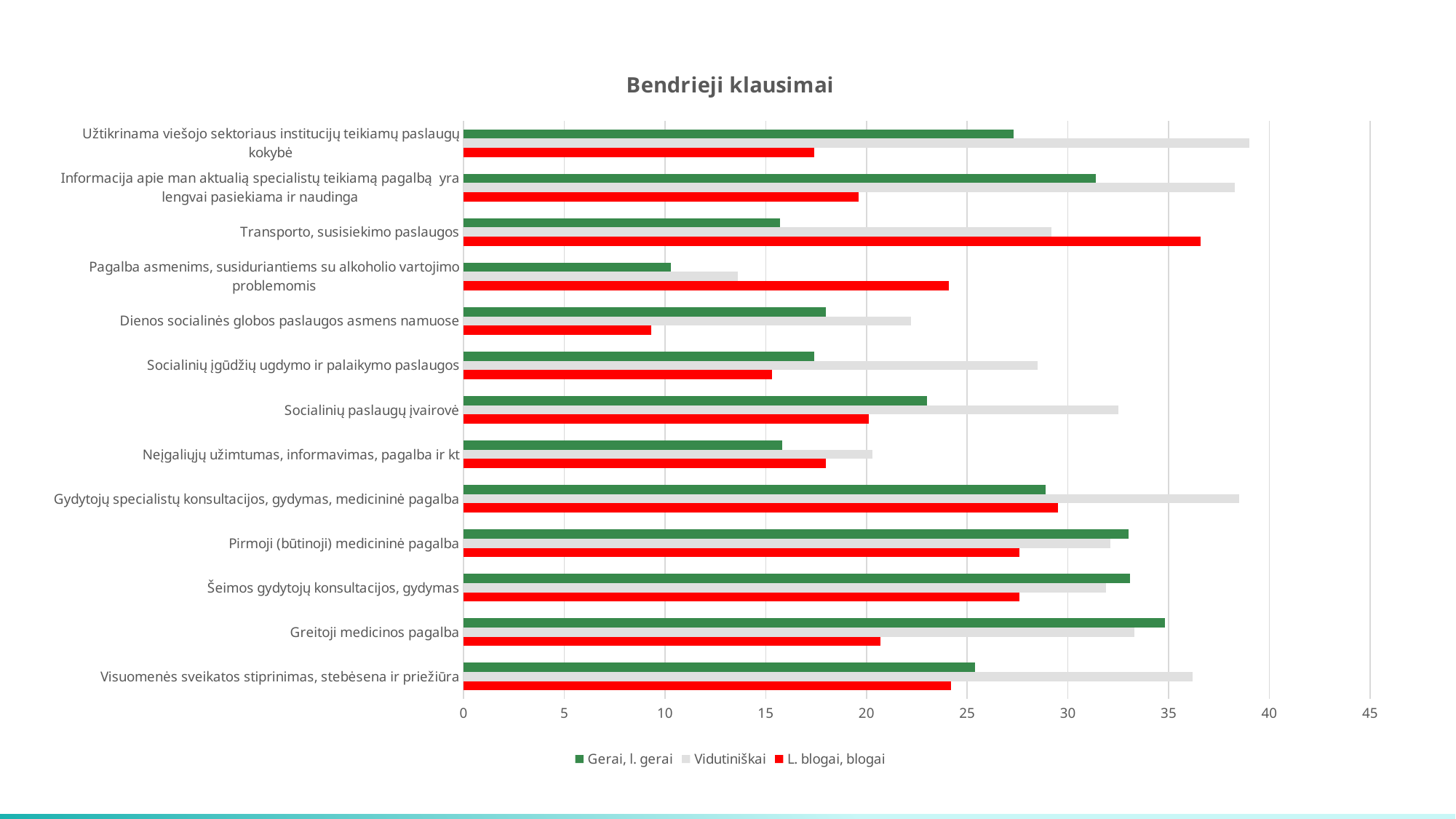
How many categories are shown on the chart? 13 Which category has the highest value for the 'L. blogai, blogai' series? Transporto, susisiekimo paslaugos Is the 'Gerai, l. gerai' value for 'Pagalba asmenims, susiduriantiems su alkoholio vartojimo problemomis' greater or less than 15? less Which category has the lowest value for the 'L. blogai, blogai' series? Dienos socialinės globos paslaugos asmens namuose Which colour represents the 'L. blogai, blogai' series? red What kind of chart is shown on the slide? bar chart How many series does the legend list? 3 What is the title of the chart? Bendrieji klausimai For 'Transporto, susisiekimo paslaugos', which is larger: the 'Gerai, l. gerai' value or the 'L. blogai, blogai' value? L. blogai, blogai Is the 'Vidutiniškai' value for 'Užtikrinama viešojo sektoriaus institucijų teikiamų paslaugų kokybė' greater or less than 35? greater Is the 'L. blogai, blogai' value for 'Transporto, susisiekimo paslaugos' greater or less than 35? greater Which category has the lowest value for the 'Gerai, l. gerai' series? Pagalba asmenims, susiduriantiems su alkoholio vartojimo problemomis